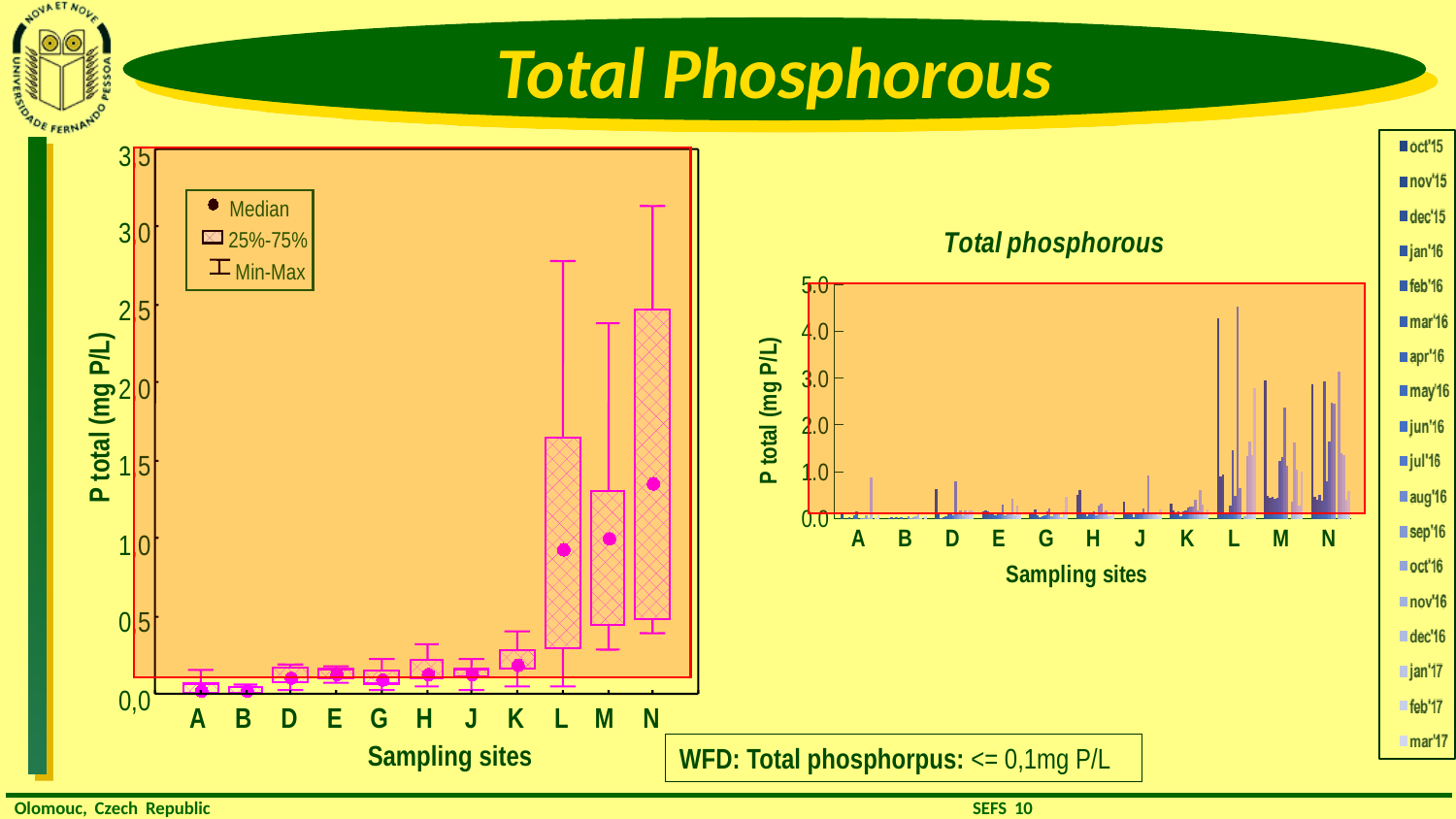
On the left box plot chart, which site has the larger median, K or L? L On the left box plot chart, is the median for site N greater or less than 1,0 mg P/L? greater On the right-hand 'Total phosphorous' chart, how many series does the legend list? 18 On the left box plot chart, how many sampling sites are shown on the x axis? 11 What kind of chart is the right-hand chart titled 'Total phosphorous'? bar chart On the left box plot chart, which sampling site has the highest maximum value? N On the left box plot chart, how many entries does the legend list? 3 On the left box plot chart, what is the label of the y axis? P total (mg P/L) On the left box plot chart, is the median for site A greater or less than 0,5 mg P/L? less On the left box plot chart, which sampling site has the highest median P total? N On the right-hand 'Total phosphorous' chart, is the tallest bar at site L greater or less than 4.0? greater On the right-hand 'Total phosphorous' chart, how many sampling sites are shown on the x axis? 11